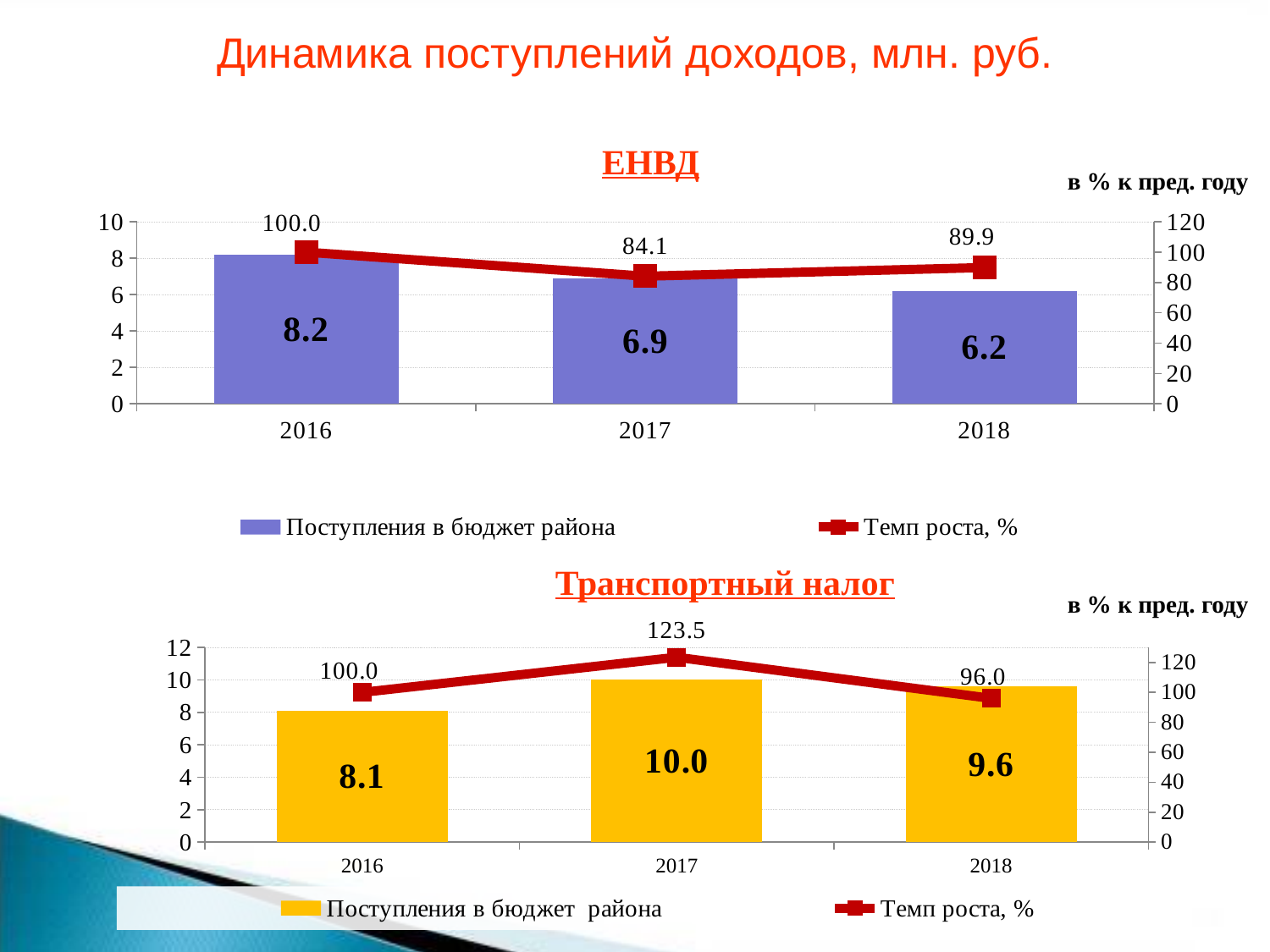
In the ЕНВД chart, what is the difference between Поступления в бюджет района in 2016 and 2018? 2.0 How many series does the legend of the Транспортный налог chart list? 2 In the ЕНВД chart, do the Поступления в бюджет района values rise or fall from 2016 to 2018? fall In the Транспортный налог chart, what is the difference between Темп роста, % in 2017 and 2016? 23.5 In the ЕНВД chart, what is the Темп роста, % value for 2018? 89.9 In the Транспортный налог chart, which year has the highest Поступления в бюджет района? 2017 In the ЕНВД chart, which year has the lowest Поступления в бюджет района? 2018 In the Транспортный налог chart, what is the value of Поступления в бюджет района for 2018? 9.6 In the ЕНВД chart, what is the value of Поступления в бюджет района for 2017? 6.9 How many years are shown on the x axis of the ЕНВД chart? 3 In the Транспортный налог chart, what is the Темп роста, % value for 2017? 123.5 In the Транспортный налог chart, which is larger: Поступления в бюджет района in 2016 or in 2018? 2018